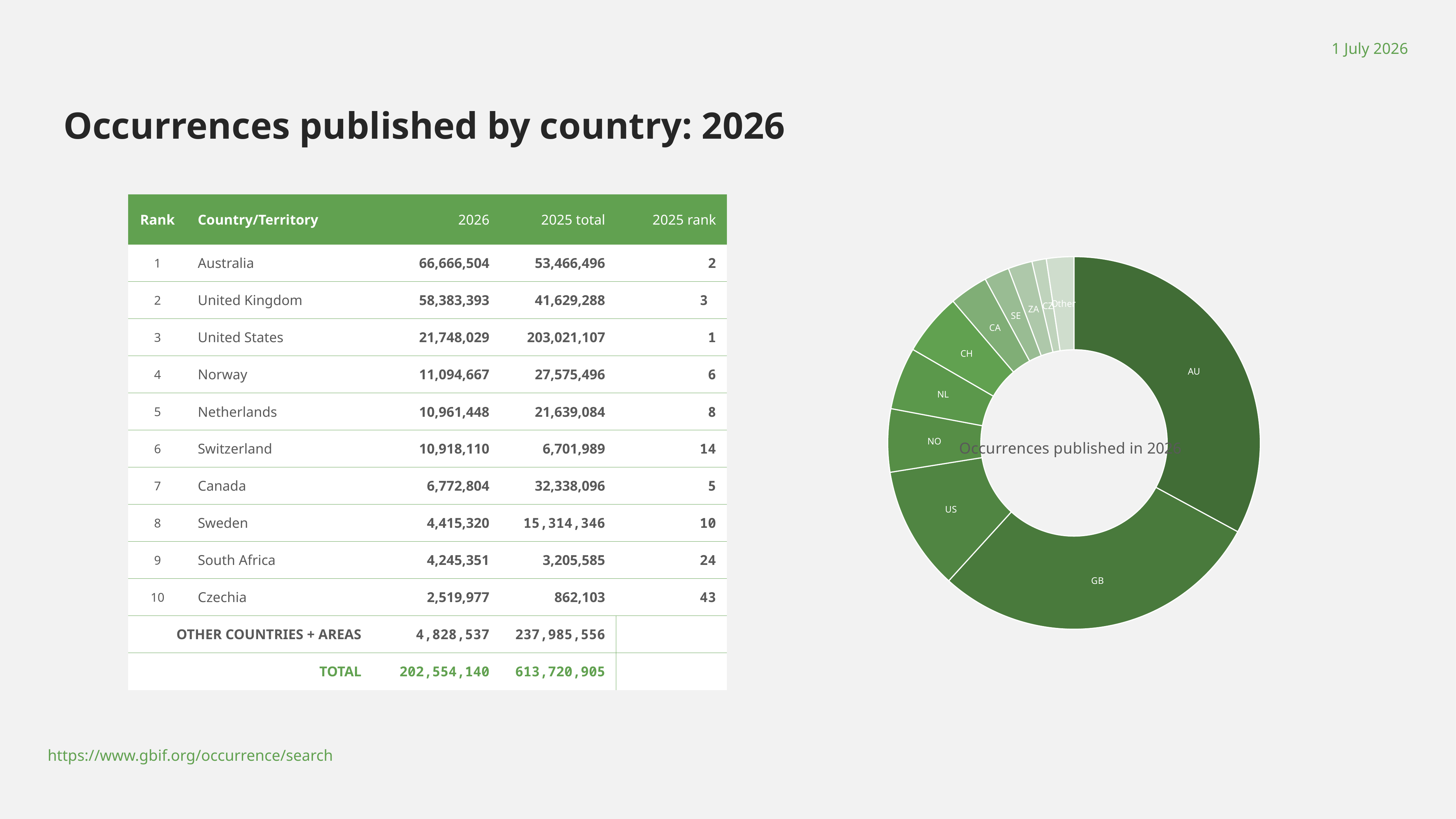
How many segments does the donut chart have? 11 Which segment of the donut chart is the largest? AU In the donut chart, which segment is larger, GB or US? GB Which labelled country segment of the donut chart is the smallest? CZ According to the slide, how many occurrences were published in 2026 for the AU segment (Australia)? 66,666,504 What kind of chart is shown on the right of the slide? donut chart What is the difference between the 2026 values for Australia and the United Kingdom shown on the slide? 8,283,111 In the donut chart, which segment is larger, US or NO? US According to the slide, how many occurrences were published in 2026 for the GB segment (United Kingdom)? 58,383,393 What is the title printed in the centre of the donut chart? Occurrences published in 2026 In the donut chart, which segment is larger, CA or SE? CA What is the total number of occurrences published in 2026 shown on the slide? 202,554,140